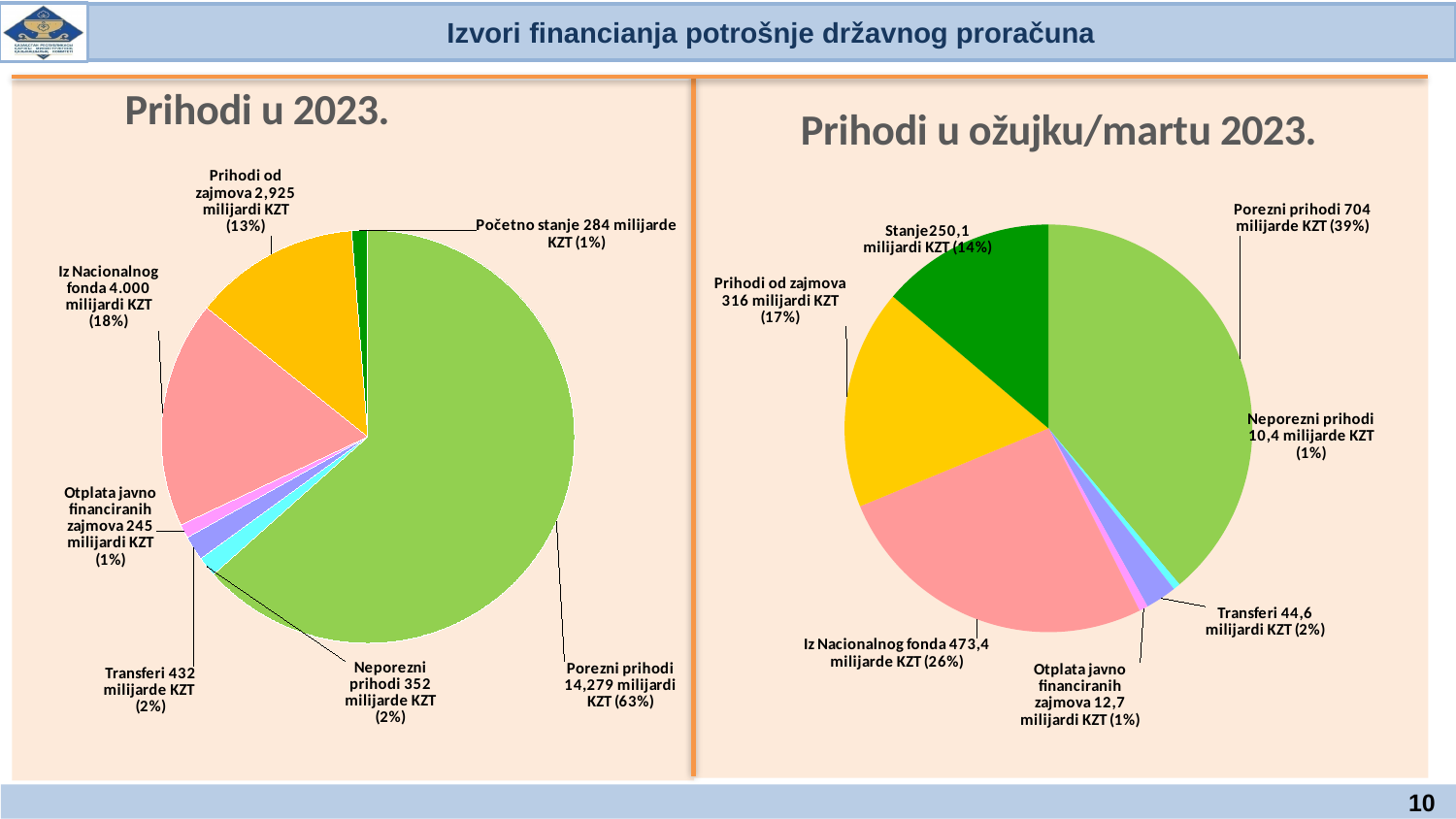
In the 'Prihodi u 2023.' chart, what share of the pie is Prihodi od zajmova? 13% In the 'Prihodi u 2023.' chart, how many slices does the pie have? 7 In the 'Prihodi u 2023.' chart, which category has the largest slice? Porezni prihodi In the 'Prihodi u 2023.' chart, what is the value for Porezni prihodi? 14,279 milijardi KZT What is the title of the chart on the right side of the slide? Prihodi u ožujku/martu 2023. In the 'Prihodi u ožujku/martu 2023.' chart, how many slices does the pie have? 7 In the 'Prihodi u 2023.' chart, what share of the pie is Iz Nacionalnog fonda? 18% What type of charts are shown on the slide? Pie charts In the 'Prihodi u ožujku/martu 2023.' chart, what is the value for Iz Nacionalnog fonda? 473,4 milijarde KZT In the 'Prihodi u ožujku/martu 2023.' chart, what is the value for Transferi? 44,6 milijardi KZT In the 'Prihodi u ožujku/martu 2023.' chart, which is larger: Prihodi od zajmova or Stanje? Prihodi od zajmova In the 'Prihodi u ožujku/martu 2023.' chart, what share of the pie is Porezni prihodi? 39%